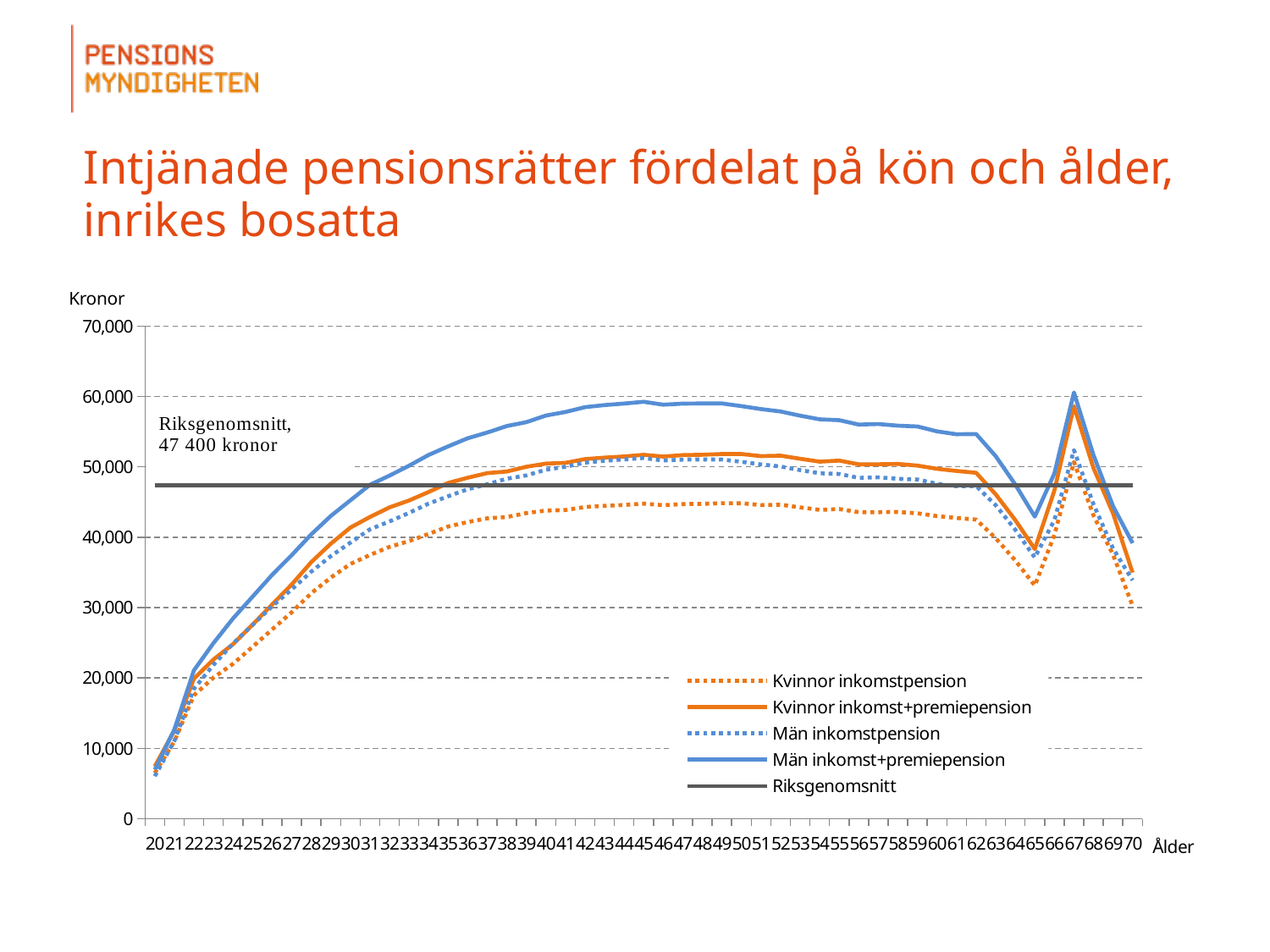
Do the values for Män inkomst+premiepension rise or fall between age 20 and age 30? rise What is the label of the vertical axis? Kronor Is the value for Män inkomst+premiepension at age 45 greater or less than 50,000? greater What is the value of the Riksgenomsnitt line according to the annotation on the chart? 47 400 kronor Is the value for Kvinnor inkomstpension at age 45 greater or less than 50,000? less How many series does the legend list? 5 What kind of chart is shown on the slide? line chart Is the value for Kvinnor inkomst+premiepension at age 64 greater or less than 40,000? greater At age 45, which is larger: Män inkomst+premiepension or Kvinnor inkomst+premiepension? Män inkomst+premiepension Which series has the highest value at age 40? Män inkomst+premiepension What is the title of the chart on the slide? Intjänade pensionsrätter fördelat på kön och ålder, inrikes bosatta